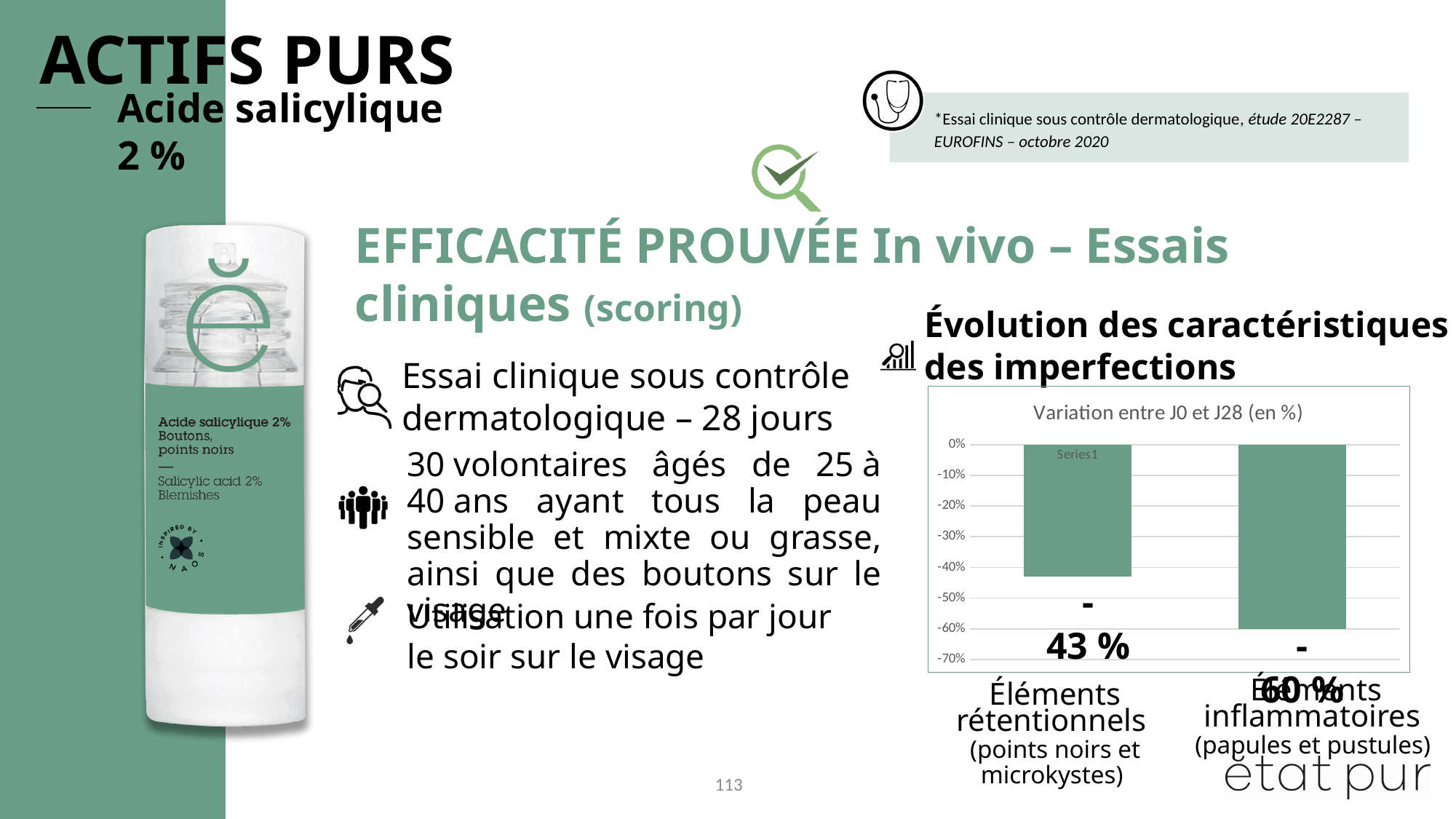
What is the title of the chart? Variation entre J0 et J28 (en %) Is the value for Éléments rétentionnels greater or less than -50%? greater Is the value for Éléments inflammatoires greater or less than -50%? less How many categories does the chart show? 2 Which category shows the smaller decrease? Éléments rétentionnels What is the value shown for Éléments rétentionnels? - 43 % Which category shows the larger decrease? Éléments inflammatoires What is the lowest tick value shown on the vertical axis? -70% Do the values fall or rise from Éléments rétentionnels to Éléments inflammatoires? fall What type of chart is shown on the slide? bar chart What is the difference in percentage points between the decrease for Éléments inflammatoires and Éléments rétentionnels? 17 What is the value shown for Éléments inflammatoires? - 60 %